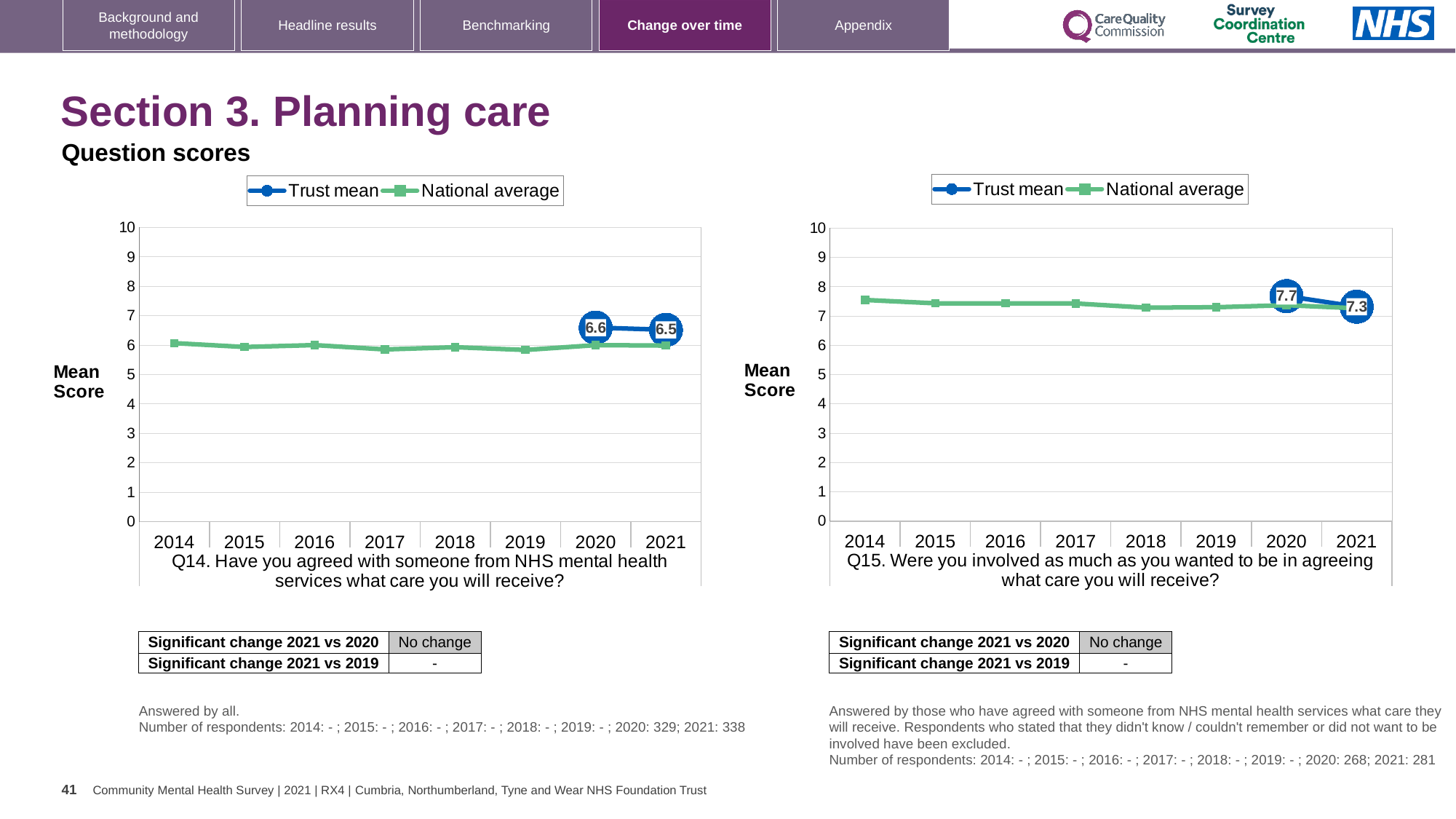
In the Q15 chart on the right, which year has the higher Trust mean, 2020 or 2021? 2020 In the Q15 chart on the right, what is the Trust mean for 2021? 7.3 In the Q15 chart on the right, is the National average for 2014 greater or less than 7? greater In the Q15 chart on the right, what is the Trust mean for 2020? 7.7 In the Q15 chart on the right, by how much did the Trust mean change from 2020 to 2021? 0.4 In the Q14 chart on the left, is the National average for 2014 greater or less than 5? greater How many series does the legend of the Q15 chart on the right list? 2 What kind of chart is the Q14 chart on the left? Line chart In the Q14 chart on the left, what is the Trust mean for 2020? 6.6 How many years are shown on the x axis of the Q14 chart on the left? 8 In the Q14 chart on the left, what is the difference between the Trust mean in 2020 and in 2021? 0.1 In the Q14 chart on the left, what is the Trust mean for 2021? 6.5